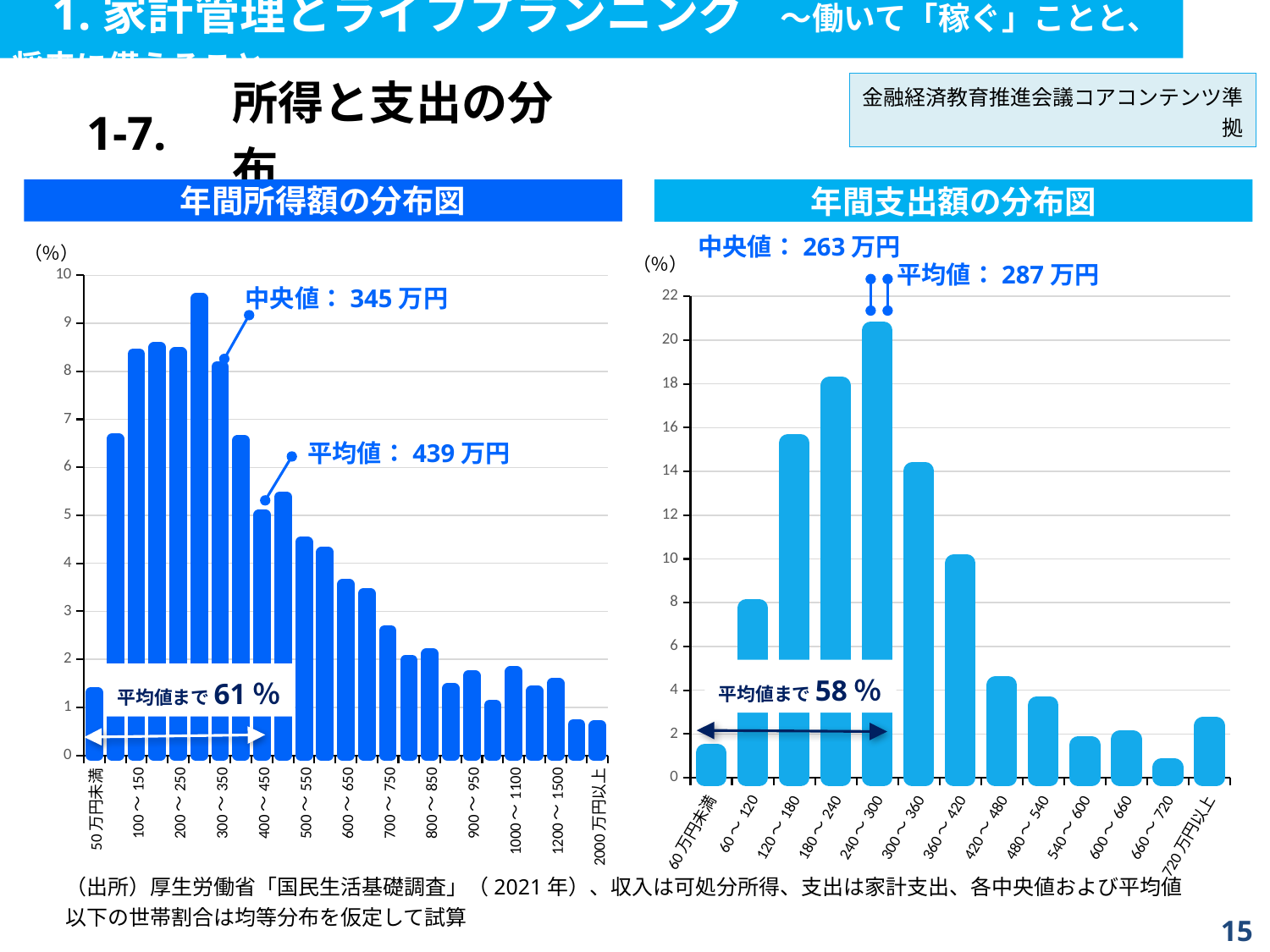
On the 年間所得額の分布図 chart, is the value for 700～750 greater or less than 3? less On the 年間所得額の分布図 chart, what share of households is indicated as being up to the mean (平均値まで)? 61 % On the 年間支出額の分布図 chart, what is the median (中央値) value? 263 万円 What kind of chart is the 年間所得額の分布図? bar chart On the 年間支出額の分布図 chart, which category has the highest bar? 240～300 On the 年間支出額の分布図 chart, is the value for 120～180 greater or less than 14? greater How many bars are plotted on the 年間支出額の分布図 chart? 13 On the 年間支出額の分布図 chart, which category has the lowest bar? 660～720 What unit is shown on the vertical axis of the 年間支出額の分布図 chart? % What is the median (中央値) shown on the 年間所得額の分布図 chart? 345 万円 What is the mean (平均値) shown on the 年間支出額の分布図 chart? 287 万円 On the 年間支出額の分布図 chart, which is larger, the bar for 180～240 or the bar for 300～360? 180～240